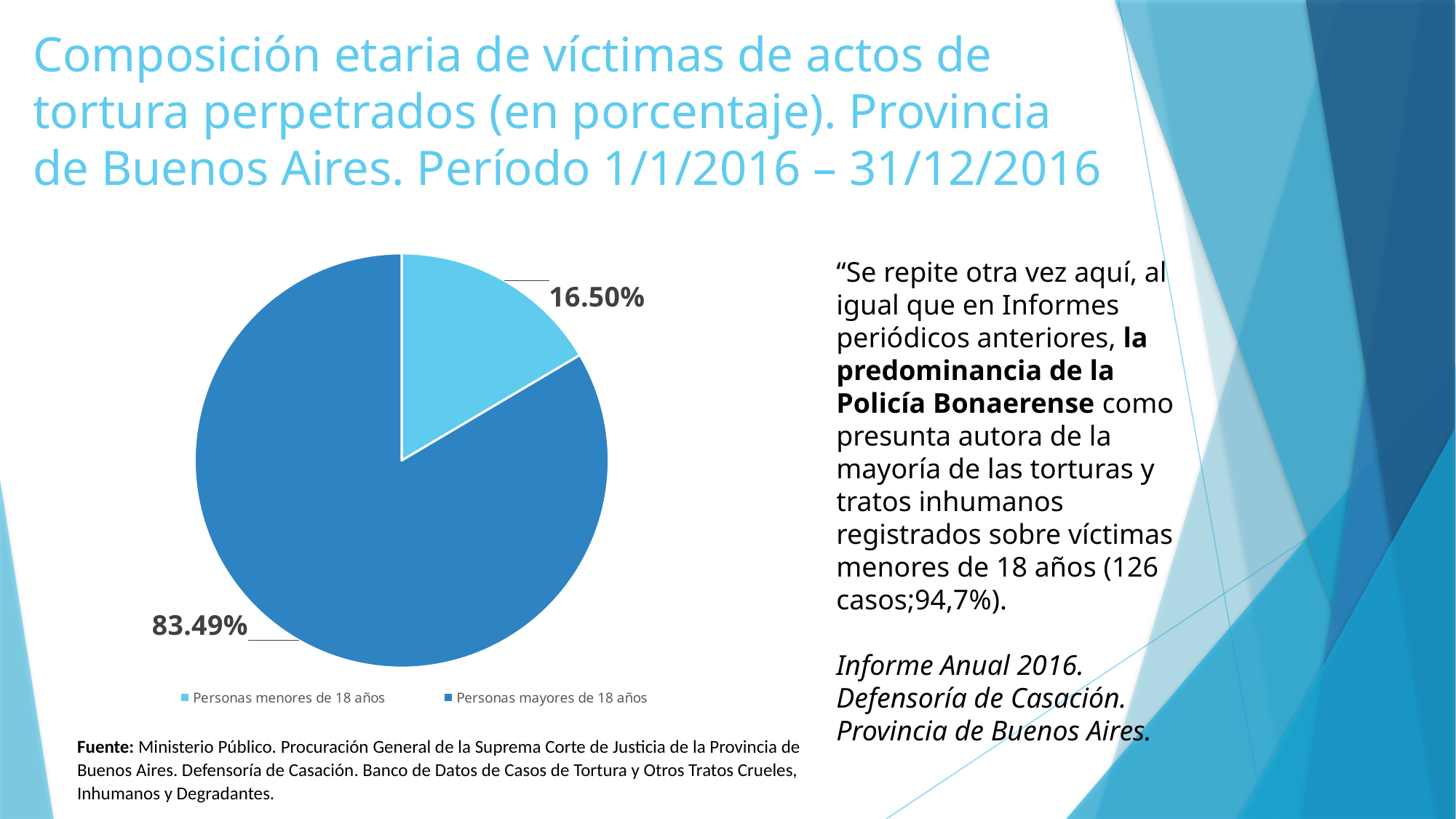
What percentage of the pie corresponds to Personas mayores de 18 años? 83.49% Which is larger, the share for Personas menores de 18 años or for Personas mayores de 18 años? Personas mayores de 18 años Which period does the chart title say the data covers? 1/1/2016 – 31/12/2016 What is the difference in percentage points between Personas mayores de 18 años and Personas menores de 18 años? 66.99 Which category has the largest share of the pie? Personas mayores de 18 años What kind of chart is shown on the slide? pie chart Which colour represents Personas menores de 18 años in the pie chart? light blue How many entries does the legend list? 2 Which category has the smallest share of the pie? Personas menores de 18 años How many categories does the pie chart show? 2 What percentage of the pie corresponds to Personas menores de 18 años? 16.50%